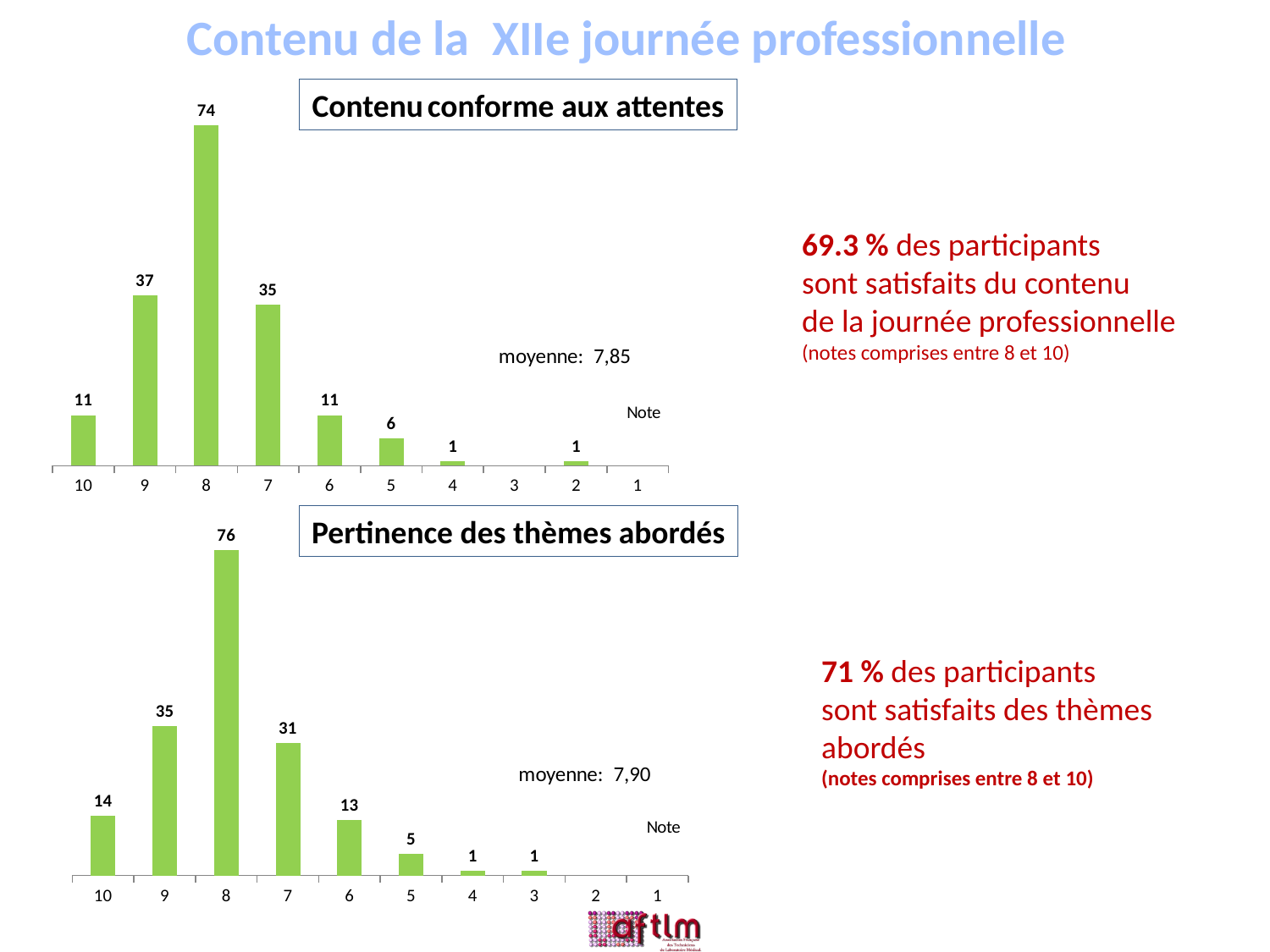
In the 'Contenu conforme aux attentes' chart, what is the difference between the values for note 8 and note 7? 39 In the 'Pertinence des thèmes abordés' chart, which is larger, the value for note 10 or the value for note 6? note 10 In the 'Pertinence des thèmes abordés' chart, what is the difference between the values for note 9 and note 7? 4 What kind of chart is the 'Pertinence des thèmes abordés' chart? bar chart In the 'Contenu conforme aux attentes' chart, what is the value for note 8? 74 In the 'Contenu conforme aux attentes' chart, what is the value for note 9? 37 How many note categories are shown on the x axis of the 'Contenu conforme aux attentes' chart? 10 In the 'Pertinence des thèmes abordés' chart, what is the value for note 6? 13 In the 'Contenu conforme aux attentes' chart, which is larger, the value for note 9 or the value for note 7? note 9 In the 'Pertinence des thèmes abordés' chart, which note has the highest value? 8 In the 'Pertinence des thèmes abordés' chart, what is the value for note 10? 14 What is the 'moyenne' shown on the 'Contenu conforme aux attentes' chart? 7,85